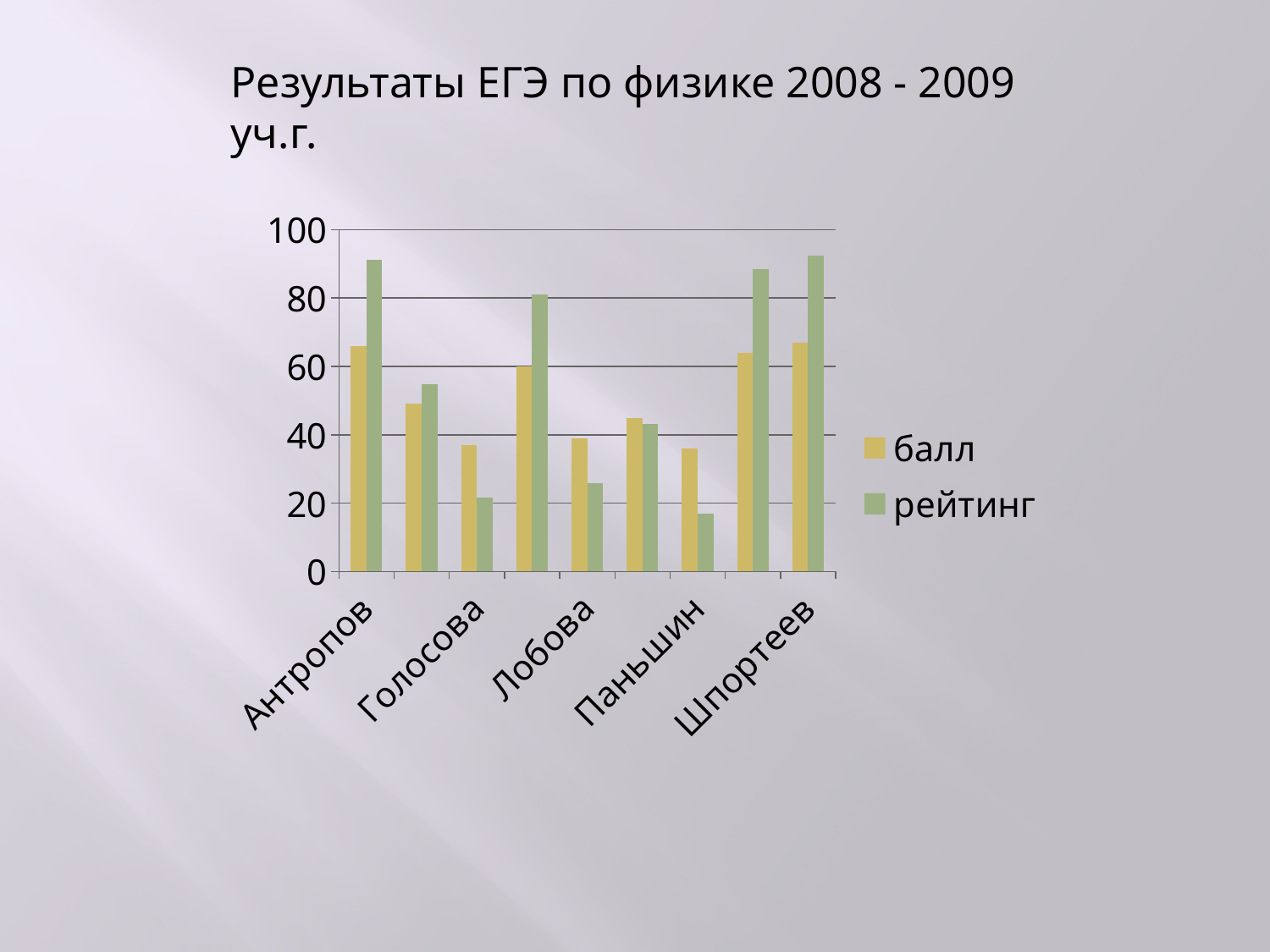
For Антропов, which is larger: балл or рейтинг? рейтинг What is the title of the chart? Результаты ЕГЭ по физике 2008 - 2009 уч.г. Is the рейтинг value for Паньшин greater or less than 40? less What are the two series named in the legend? балл and рейтинг For Паньшин, which is larger: балл or рейтинг? балл How many series does the legend list? 2 Is the рейтинг value for Шпортеев greater or less than 80? greater Is the балл value for Лобова greater or less than 60? less What kind of chart is shown on the slide? bar chart